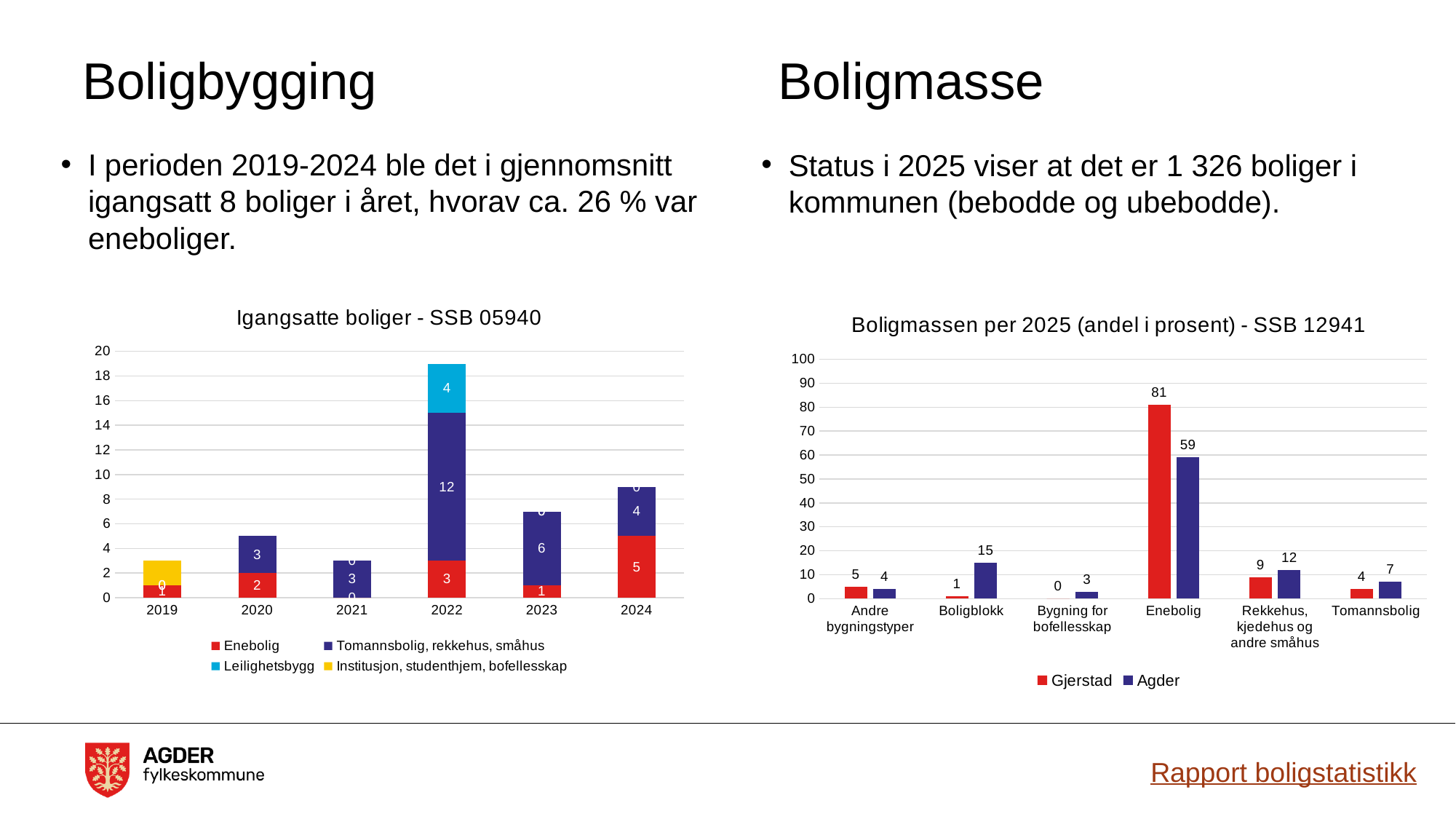
In the chart 'Igangsatte boliger - SSB 05940', what is the value for Leilighetsbygg in 2022? 4 What kind of chart is 'Boligmassen per 2025 (andel i prosent) - SSB 12941'? Bar chart In the chart 'Igangsatte boliger - SSB 05940', which year has the highest total of igangsatte boliger? 2022 In the chart 'Boligmassen per 2025 (andel i prosent) - SSB 12941', which is larger for Boligblokk, Gjerstad or Agder? Agder In the chart 'Igangsatte boliger - SSB 05940', what is the value for Tomannsbolig, rekkehus, småhus in 2022? 12 In the chart 'Igangsatte boliger - SSB 05940', what is the value for Enebolig in 2024? 5 In the chart 'Igangsatte boliger - SSB 05940', what is the total of the stacked bar for 2022? 19 In the chart 'Boligmassen per 2025 (andel i prosent) - SSB 12941', what is the value for Agder for Rekkehus, kjedehus og andre småhus? 12 In the chart 'Boligmassen per 2025 (andel i prosent) - SSB 12941', how many categories are shown on the x axis? 6 In the chart 'Boligmassen per 2025 (andel i prosent) - SSB 12941', what is the value for Gjerstad for Enebolig? 81 In the chart 'Boligmassen per 2025 (andel i prosent) - SSB 12941', what is the difference between Gjerstad and Agder for Enebolig? 22 In the chart 'Igangsatte boliger - SSB 05940', how many series does the legend list? 4